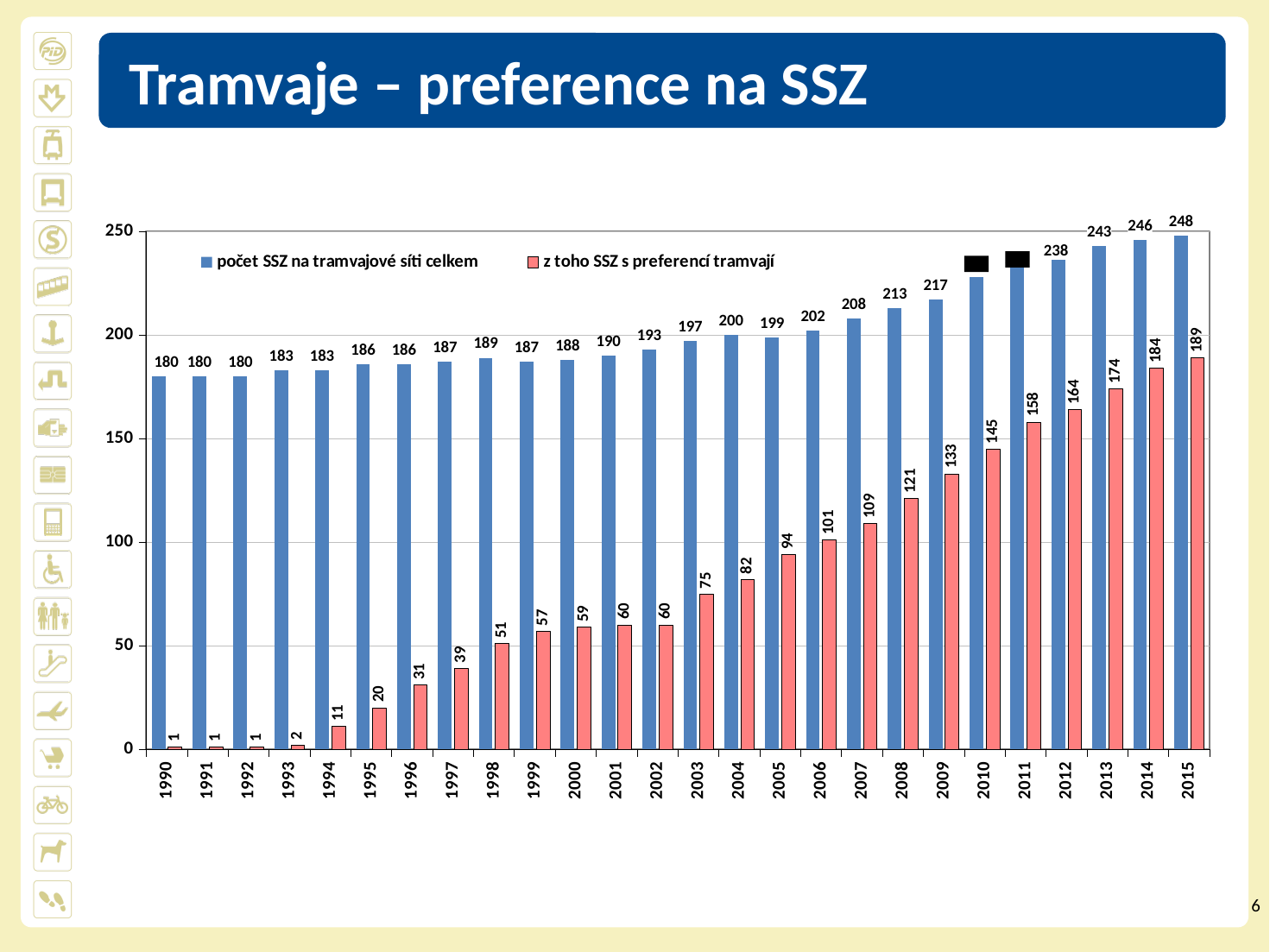
What is the difference between 'počet SSZ na tramvajové síti celkem' and 'z toho SSZ s preferencí tramvají' in 2015? 59 What is the value of 'počet SSZ na tramvajové síti celkem' for 2015? 248 Which is larger: 'z toho SSZ s preferencí tramvají' in 2005 or in 2006? 2006 What is the value of 'z toho SSZ s preferencí tramvají' for 1998? 51 Does the value of 'z toho SSZ s preferencí tramvají' generally rise or fall from 1990 to 2015? rise What is the value of 'z toho SSZ s preferencí tramvají' for 2009? 133 Which year has the lowest value for 'počet SSZ na tramvajové síti celkem' among the labelled bars? 1990, 1991 and 1992 (tied at 180) How many years are shown on the x axis? 26 What colour are the bars for 'z toho SSZ s preferencí tramvají'? red How many series does the legend list? 2 Which year has the highest value for 'z toho SSZ s preferencí tramvají'? 2015 What type of chart is shown on the slide? bar chart